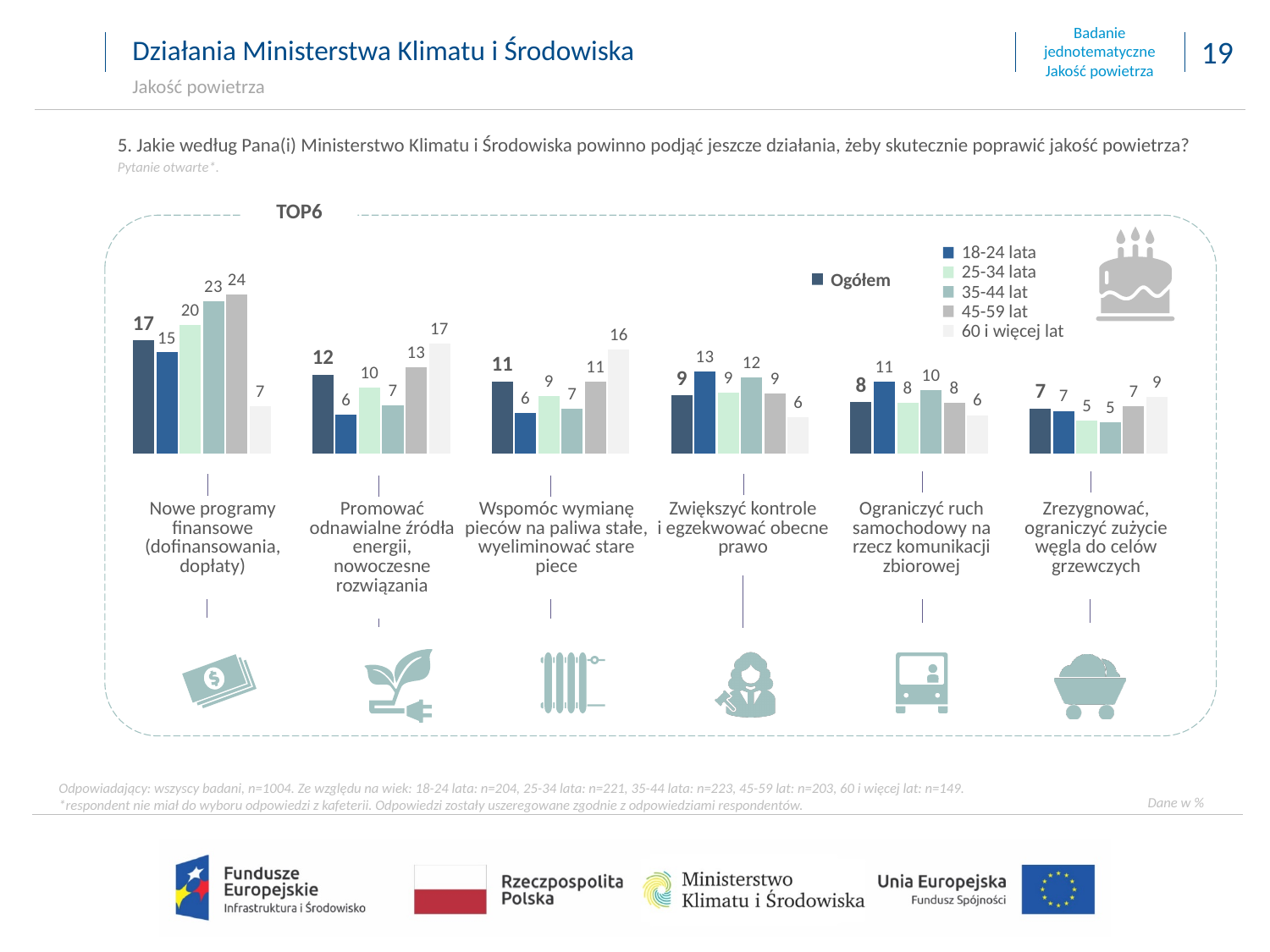
Within "Nowe programy finansowe (dofinansowania, dopłaty)", which age group has the lowest value? 60 i więcej lat Which category has the lowest Ogółem value? Zrezygnować, ograniczyć zużycie węgla do celów grzewczych What type of chart is shown on the slide? Bar chart Which category has the highest Ogółem value? Nowe programy finansowe (dofinansowania, dopłaty) How many series does the legend list? 6 What is the value for the 60 i więcej lat group for "Promować odnawialne źródła energii, nowoczesne rozwiązania"? 17 How many categories (actions) are shown in the chart? 6 For "Wspomóc wymianę pieców na paliwa stałe, wyeliminować stare piece", which is larger: the 60 i więcej lat value or the 18-24 lata value? 60 i więcej lat What is the Ogółem value for "Ograniczyć ruch samochodowy na rzecz komunikacji zbiorowej"? 8 What is the difference between the 45-59 lat value and the 60 i więcej lat value for "Nowe programy finansowe (dofinansowania, dopłaty)"? 17 What is the Ogółem value for "Nowe programy finansowe (dofinansowania, dopłaty)"? 17 What is the value for the 18-24 lata group for "Zwiększyć kontrole i egzekwować obecne prawo"? 13